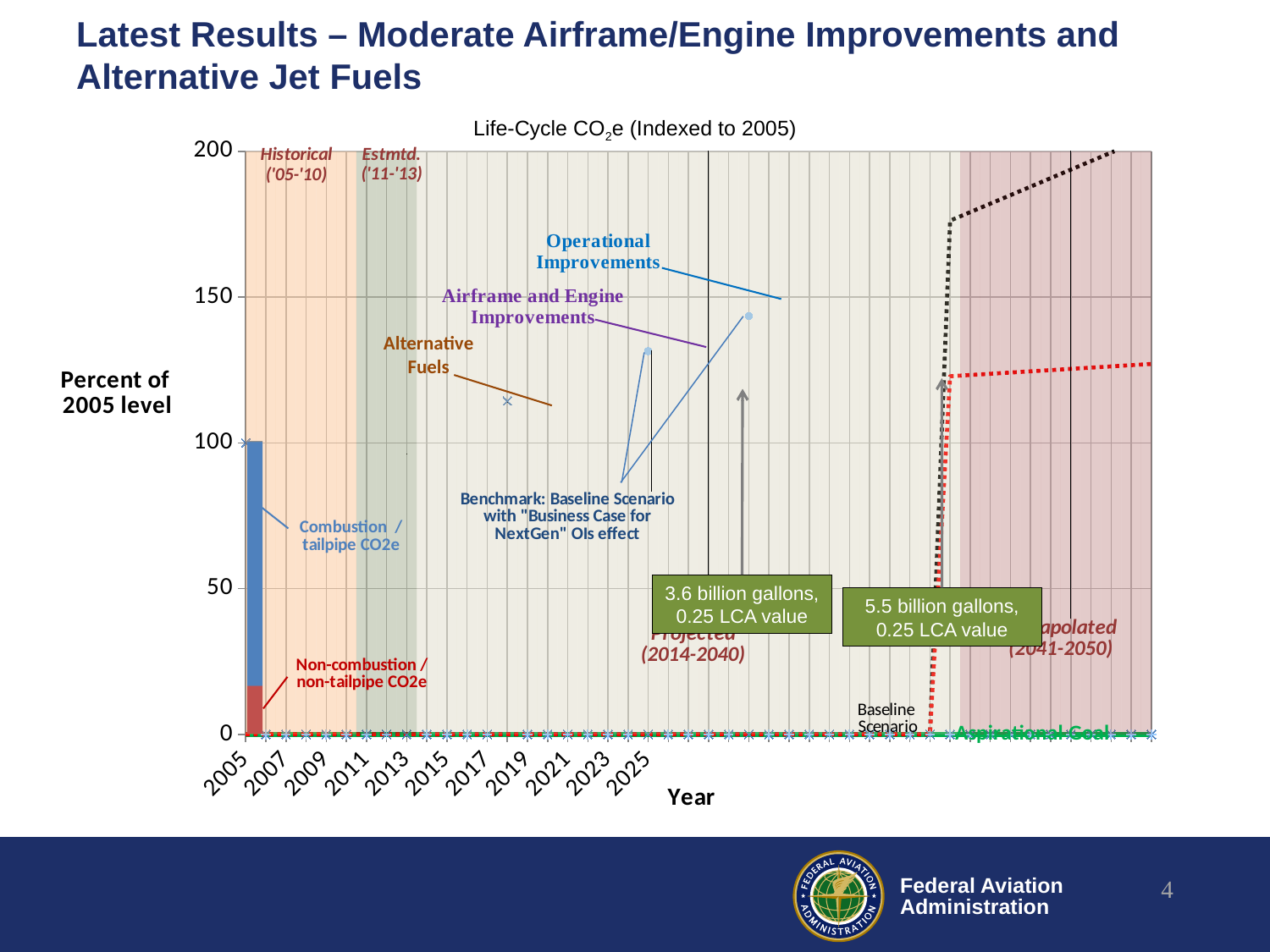
In the 2005 stacked bar, which segment is larger: Combustion / tailpipe CO2e or Non-combustion / non-tailpipe CO2e? Combustion / tailpipe CO2e Is the value of the Alternative Fuels marker greater or less than 150? less Is the value of the Airframe and Engine Improvements marker greater or less than 100? greater What is the highest value shown on the vertical axis? 200 How many year labels are shown along the x axis? 11 What is the title of the chart? Life-Cycle CO2e (Indexed to 2005) What is the label on the vertical axis of the chart? Percent of 2005 level Is the value of the Alternative Fuels marker greater or less than 100? greater What is the first year label shown on the x axis? 2005 Which marker is higher on the chart: Operational Improvements or Alternative Fuels? Operational Improvements What value does the stacked bar for 2005 reach on the vertical axis? 100